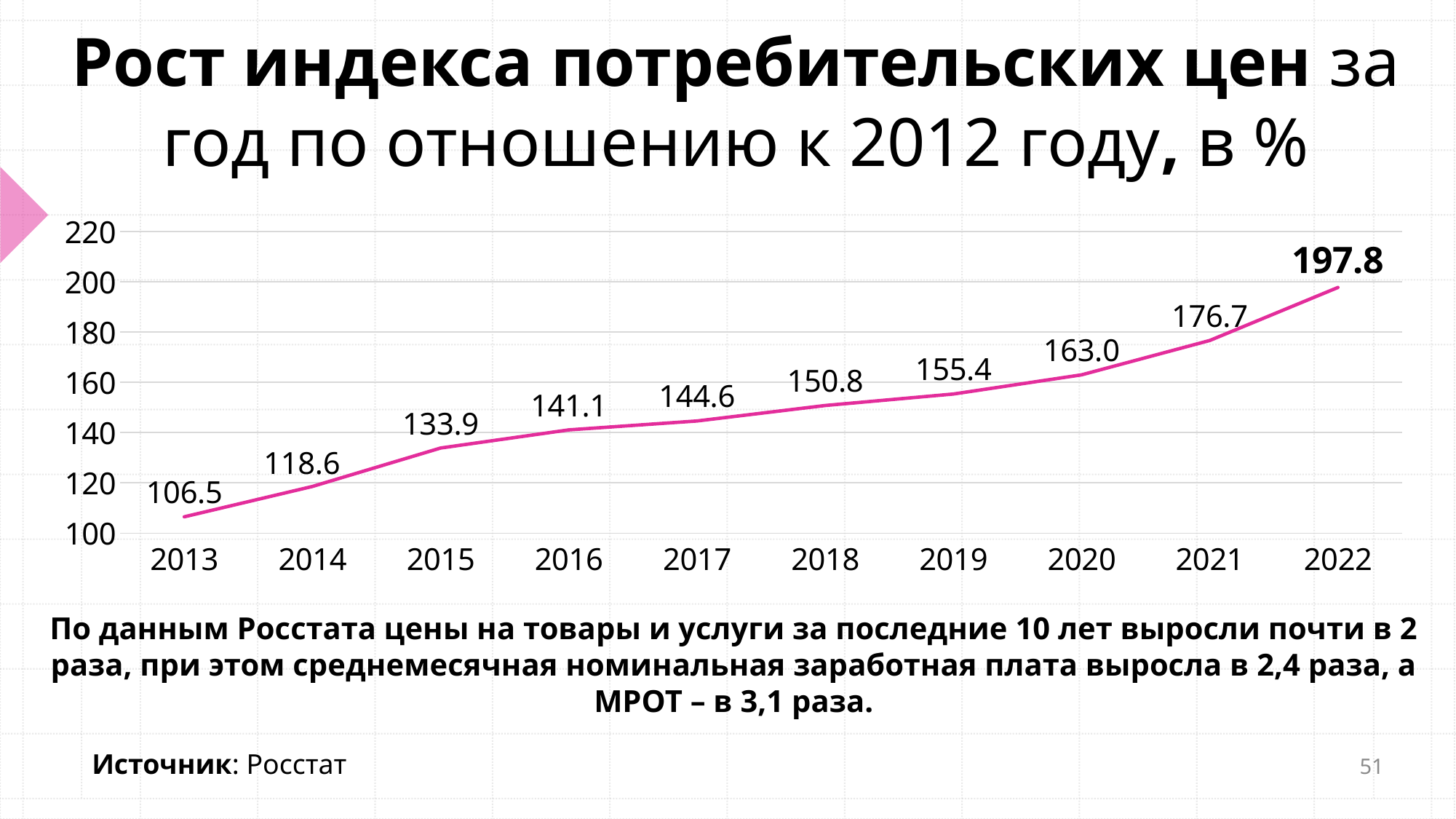
Is the value for 2020 greater or less than 160? greater What is the value for 2018? 150.8 What is the difference between the values for 2015 and 2014? 15.3 How many years are plotted on the chart? 10 What is the difference between the values for 2022 and 2021? 21.1 Which is larger, the value for 2019 or the value for 2017? 2019 What kind of chart is shown on the slide? line chart Do the values rise or fall from 2013 to 2022? rise What is the value for 2022? 197.8 What is the value for 2013? 106.5 Which year has the lowest value? 2013 Which year has the highest value? 2022